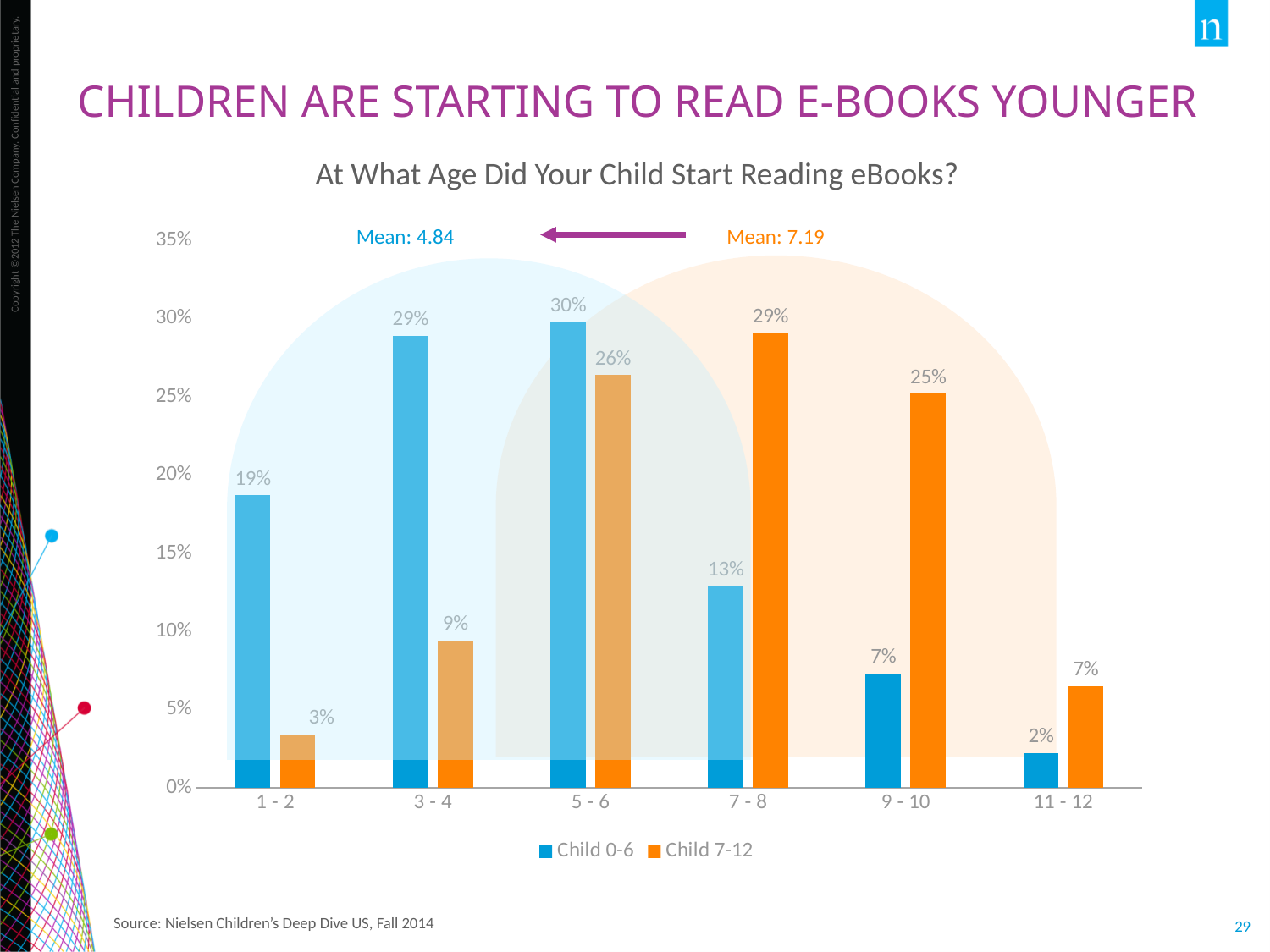
What mean age is shown for the Child 0-6 series? 4.84 In which age category is the Child 7-12 series lowest? 1 - 2 What is the value for Child 7-12 in the 9 - 10 age category? 25% In which age category is the Child 0-6 series highest? 5 - 6 Which series has the larger value in the 3 - 4 category, Child 0-6 or Child 7-12? Child 0-6 What kind of chart is shown on the slide? Bar chart What percentage of children aged 0-6 started reading eBooks at age 1 - 2? 19% Is the Child 7-12 value for the 5 - 6 category greater or less than 20%? greater Do the Child 7-12 values rise or fall from the 7 - 8 category to the 11 - 12 category? Fall What is the difference between the Child 0-6 and Child 7-12 values in the 7 - 8 category? 16 percentage points How many series does the legend list? 2 How many age categories are shown on the x axis? 6